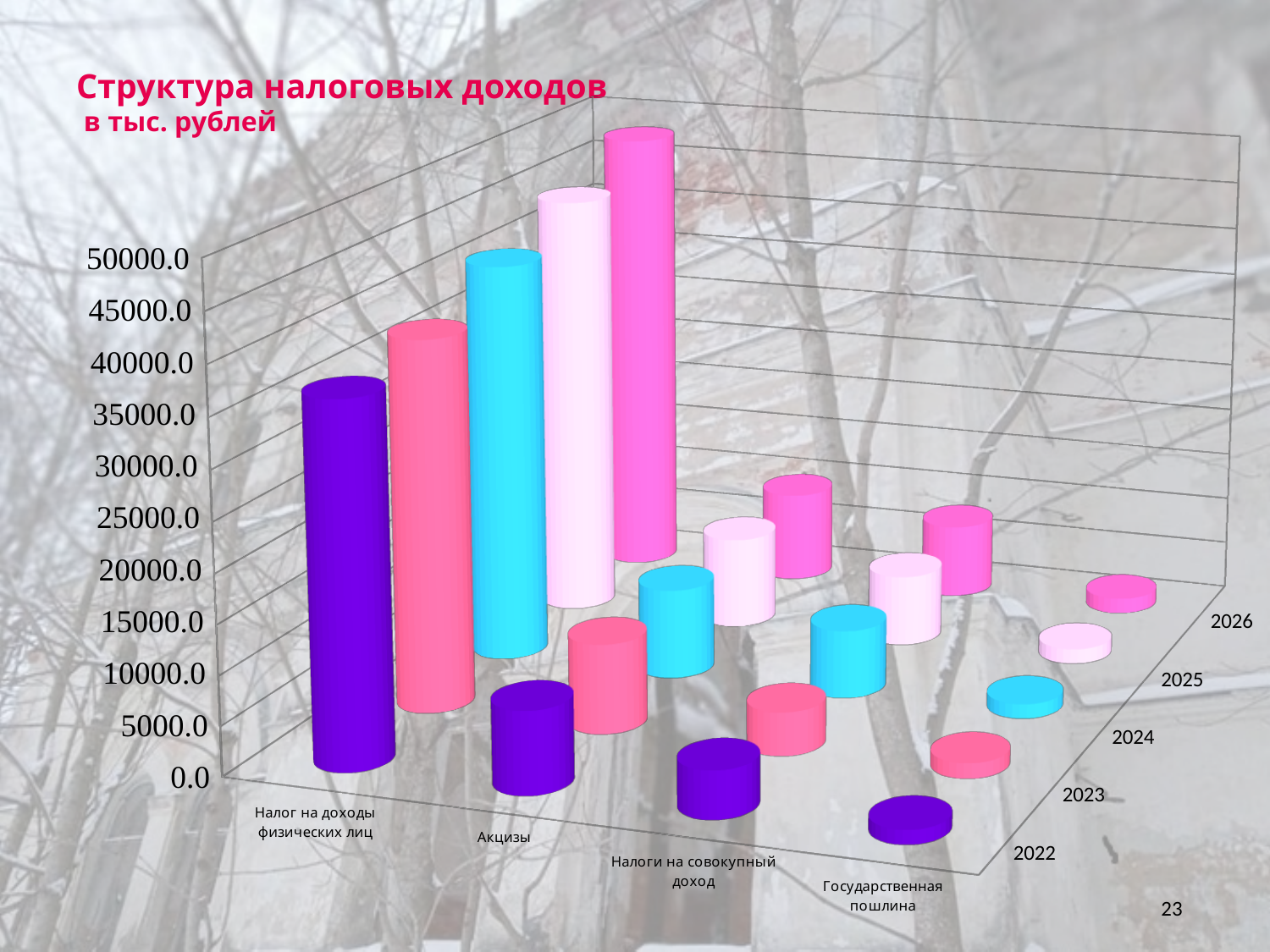
Is the value for Налог на доходы физических лиц in 2022 greater or less than 20000.0? greater Do the values for Налог на доходы физических лиц rise or fall from 2022 to 2026? rise What kind of chart is shown on the slide? bar chart Which tax category has the highest values in the chart? Налог на доходы физических лиц Which tax category has the lowest values in the chart? Государственная пошлина What is the title of the chart? Структура налоговых доходов в тыс. рублей How many years are plotted in the chart? 5 Is the value for Государственная пошлина in 2022 greater or less than 5000.0? less Which is larger in 2022: Налог на доходы физических лиц or Акцизы? Налог на доходы физических лиц What is the first year shown on the depth axis of the chart? 2022 How many tax categories are shown along the category axis? 4 Do the values for Акцизы rise or fall from 2022 to 2026? rise